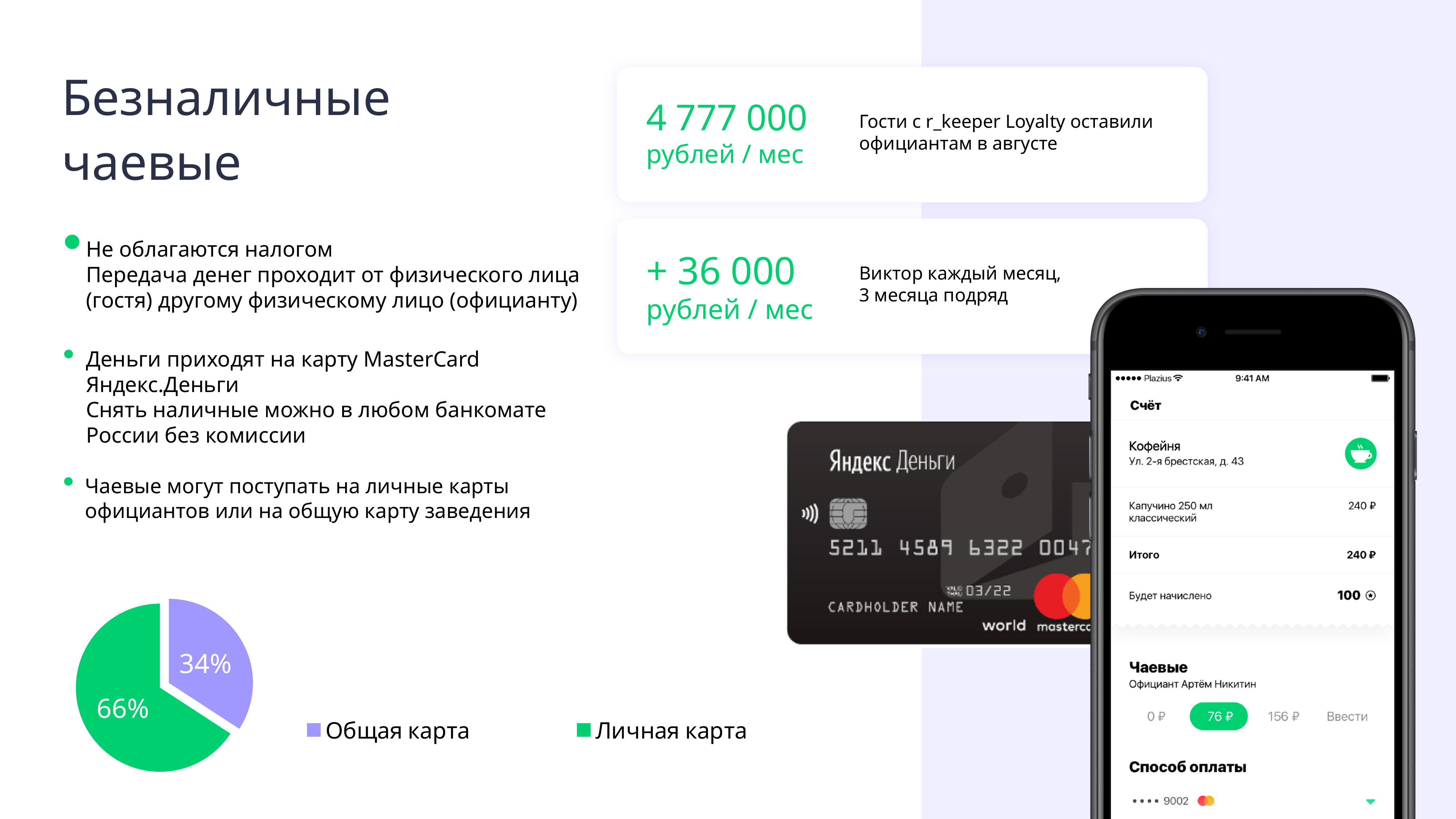
Which is larger in the pie chart, Общая карта or Личная карта? Личная карта What share of the pie does Общая карта have? 34% What kind of chart is shown at the bottom left of the slide? Pie chart How many entries does the pie chart legend list? 2 Is the share for Личная карта greater or less than 50%? greater What colour is the Общая карта slice in the pie chart? Purple What share of the pie does Личная карта have? 66% Which category has the smallest slice of the pie? Общая карта What colour is the Личная карта slice in the pie chart? Green Which category has the largest slice of the pie? Личная карта What is the difference in percentage points between Личная карта and Общая карта? 32 How many slices does the pie chart have? 2